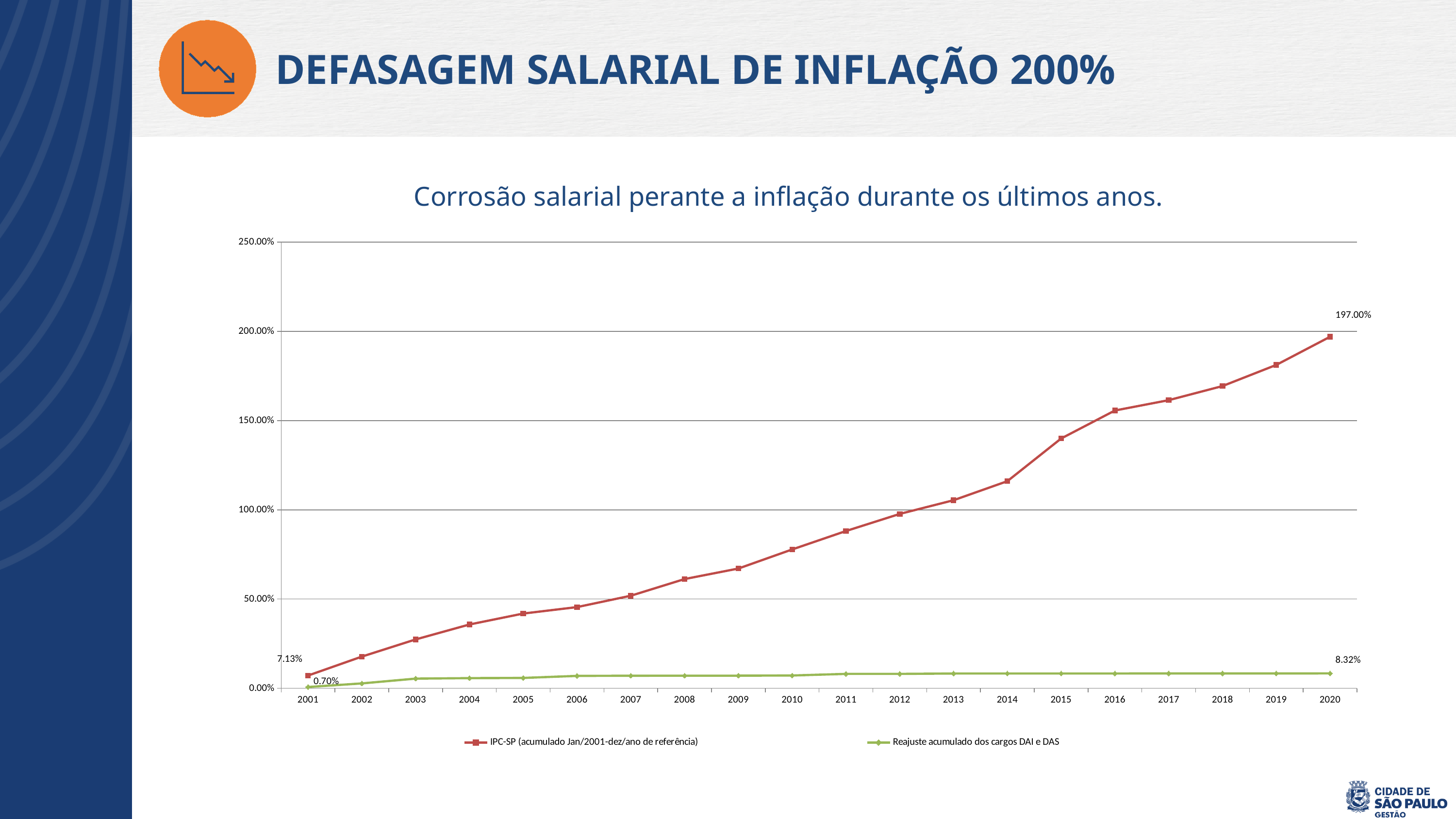
What is the value of IPC-SP (acumulado Jan/2001-dez/ano de referência) in 2020? 197.00% How many years are plotted along the x axis? 20 What is the difference between the IPC-SP value and the Reajuste acumulado value in 2020? 188.68% What is the value of Reajuste acumulado dos cargos DAI e DAS in 2001? 0.70% What is the difference between the IPC-SP value and the Reajuste acumulado value in 2001? 6.43% Is the IPC-SP value for 2010 greater or less than 100.00%? less How many series does the legend list? 2 What is the value of IPC-SP (acumulado Jan/2001-dez/ano de referência) in 2001? 7.13% What is the value of Reajuste acumulado dos cargos DAI e DAS in 2020? 8.32% What kind of chart is shown on the slide? line chart Does the IPC-SP series rise or fall from 2001 to 2020? rise In 2020, which series has the larger value, IPC-SP or Reajuste acumulado dos cargos DAI e DAS? IPC-SP